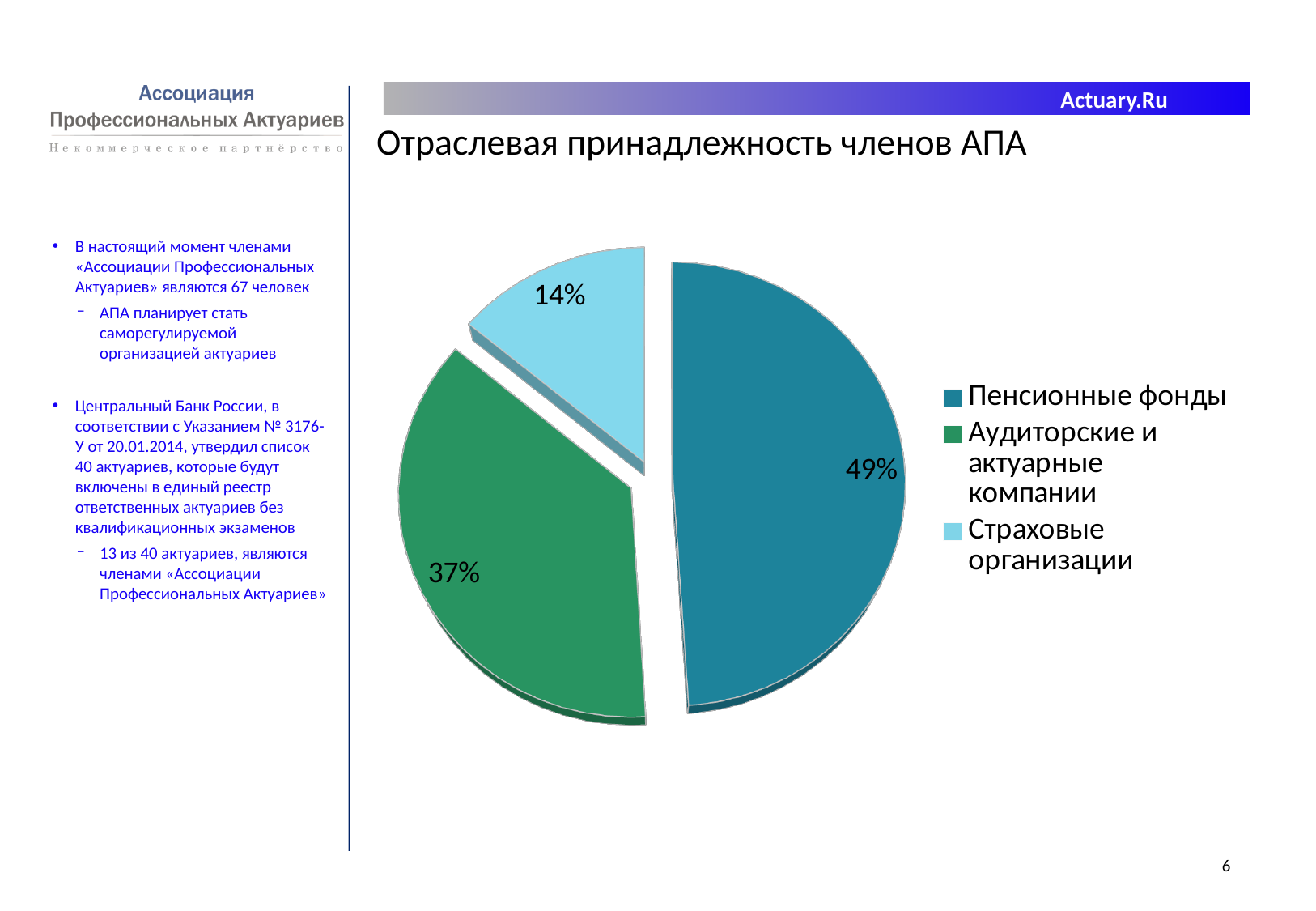
Which is larger: the share for Аудиторские и актуарные компании or for Страховые организации? Аудиторские и актуарные компании Which category is shown in light blue in the legend? Страховые организации What kind of chart is shown on the slide? Pie chart What share of the pie does Страховые организации hold? 14% What is the difference in percentage points between Аудиторские и актуарные компании and Страховые организации? 23 What share of the pie does Пенсионные фонды hold? 49% What is the difference in percentage points between Пенсионные фонды and Аудиторские и актуарные компании? 12 How many categories does the pie chart show? 3 What is the title of the chart on the slide? Отраслевая принадлежность членов АПА Which category has the smallest slice of the pie? Страховые организации What share of the pie does Аудиторские и актуарные компании hold? 37% Which category has the largest slice of the pie? Пенсионные фонды